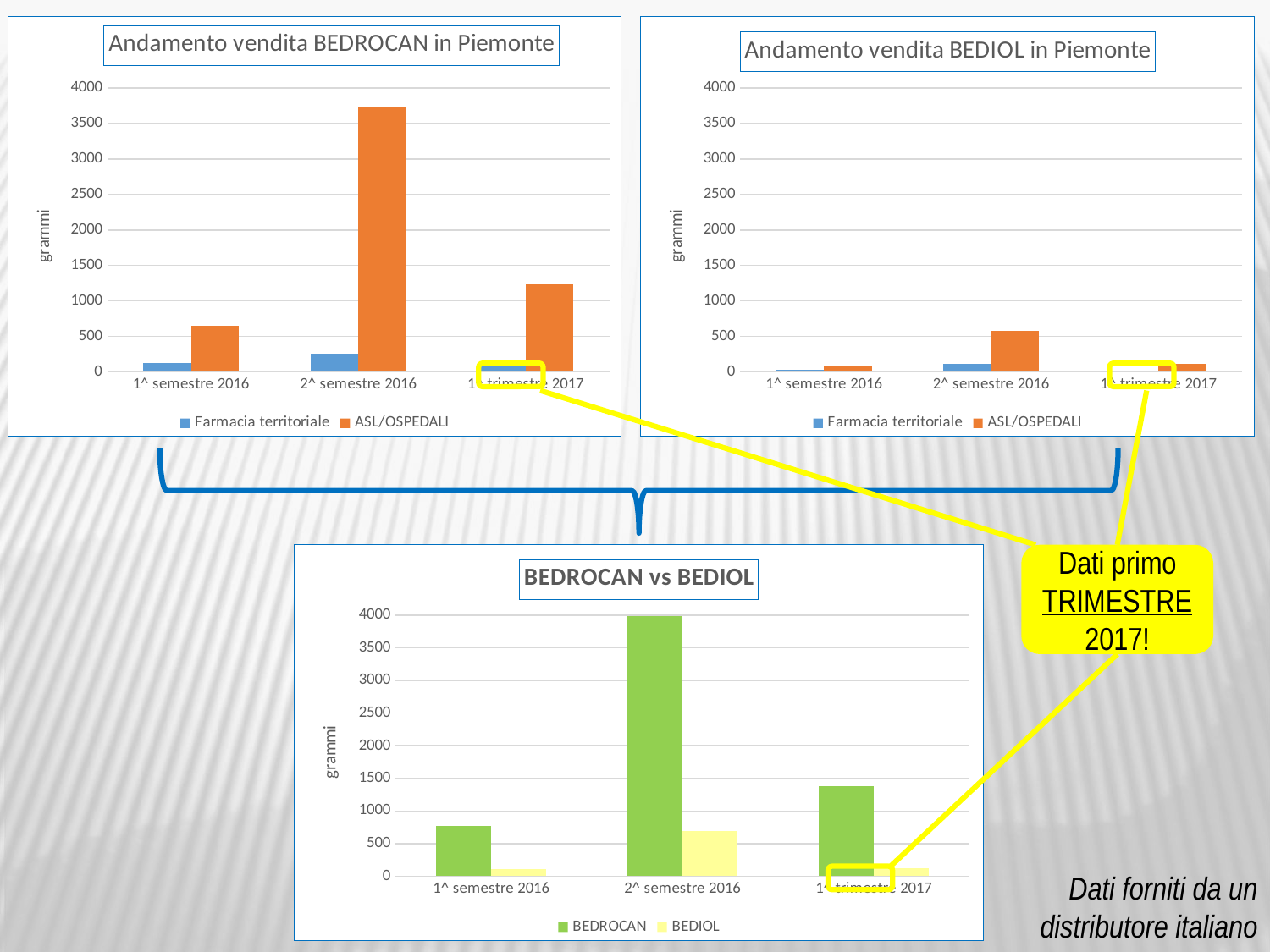
In the chart titled 'Andamento vendita BEDROCAN in Piemonte', is the ASL/OSPEDALI value for 1^ semestre 2016 greater or less than 1000? less In the chart titled 'Andamento vendita BEDIOL in Piemonte', how many categories are shown on the x axis? 3 In the chart titled 'BEDROCAN vs BEDIOL', which series has the larger value for 2^ semestre 2016, BEDROCAN or BEDIOL? BEDROCAN In the chart titled 'Andamento vendita BEDIOL in Piemonte', is the ASL/OSPEDALI value for 2^ semestre 2016 greater or less than 1000? less In the chart titled 'Andamento vendita BEDIOL in Piemonte', which category has the highest ASL/OSPEDALI value? 2^ semestre 2016 In the chart titled 'BEDROCAN vs BEDIOL', is the BEDROCAN value for 1^ trimestre 2017 greater or less than 1000? greater In the chart titled 'Andamento vendita BEDROCAN in Piemonte', which category has the highest ASL/OSPEDALI value? 2^ semestre 2016 What kind of chart is the chart titled 'BEDROCAN vs BEDIOL'? bar chart In the chart titled 'BEDROCAN vs BEDIOL', which category has the lowest BEDROCAN value? 1^ semestre 2016 In the chart titled 'Andamento vendita BEDROCAN in Piemonte', how many series does the legend list? 2 In the chart titled 'BEDROCAN vs BEDIOL', what is the label of the y axis? grammi